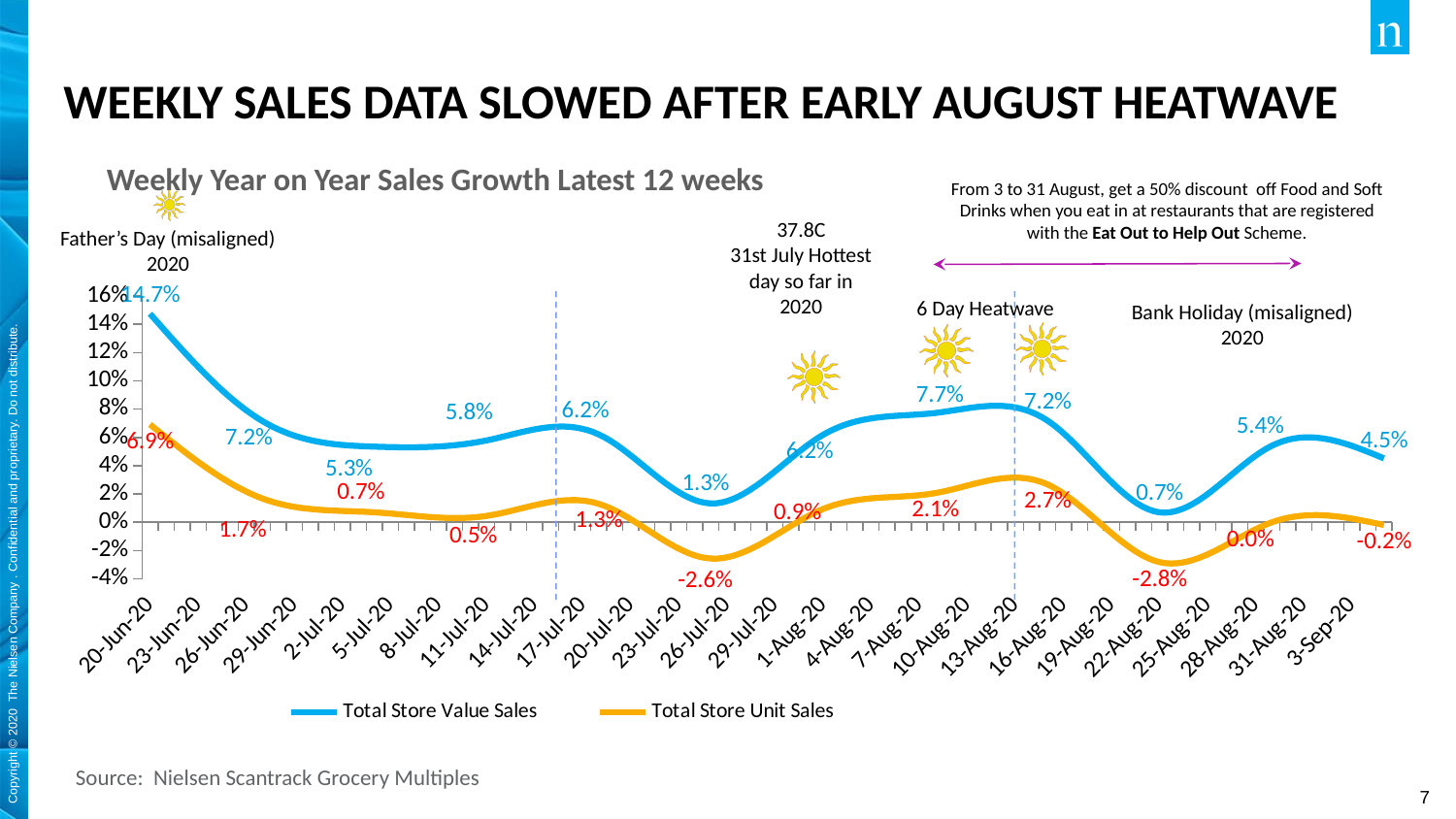
What is the lowest value shown for Total Store Unit Sales? -2.8% What is the value of the last data point for Total Store Value Sales (at the right end of the chart)? 4.5% What kind of chart is shown on the slide? Line chart What is the highest value shown for Total Store Unit Sales? 6.9% What is the lowest value shown for Total Store Value Sales? 0.7% What are the two series named in the chart's legend? Total Store Value Sales and Total Store Unit Sales How many series does the chart's legend list? 2 What is the value of the last data point for Total Store Unit Sales (at the right end of the chart)? -0.2% Overall, does the Total Store Value Sales line rise or fall from its first point to its last point? Fall What is the difference between the first data points of Total Store Value Sales (14.7%) and Total Store Unit Sales (6.9%)? 7.8 percentage points What is the title of the chart? Weekly Year on Year Sales Growth Latest 12 weeks What is the highest value shown for Total Store Value Sales? 14.7%